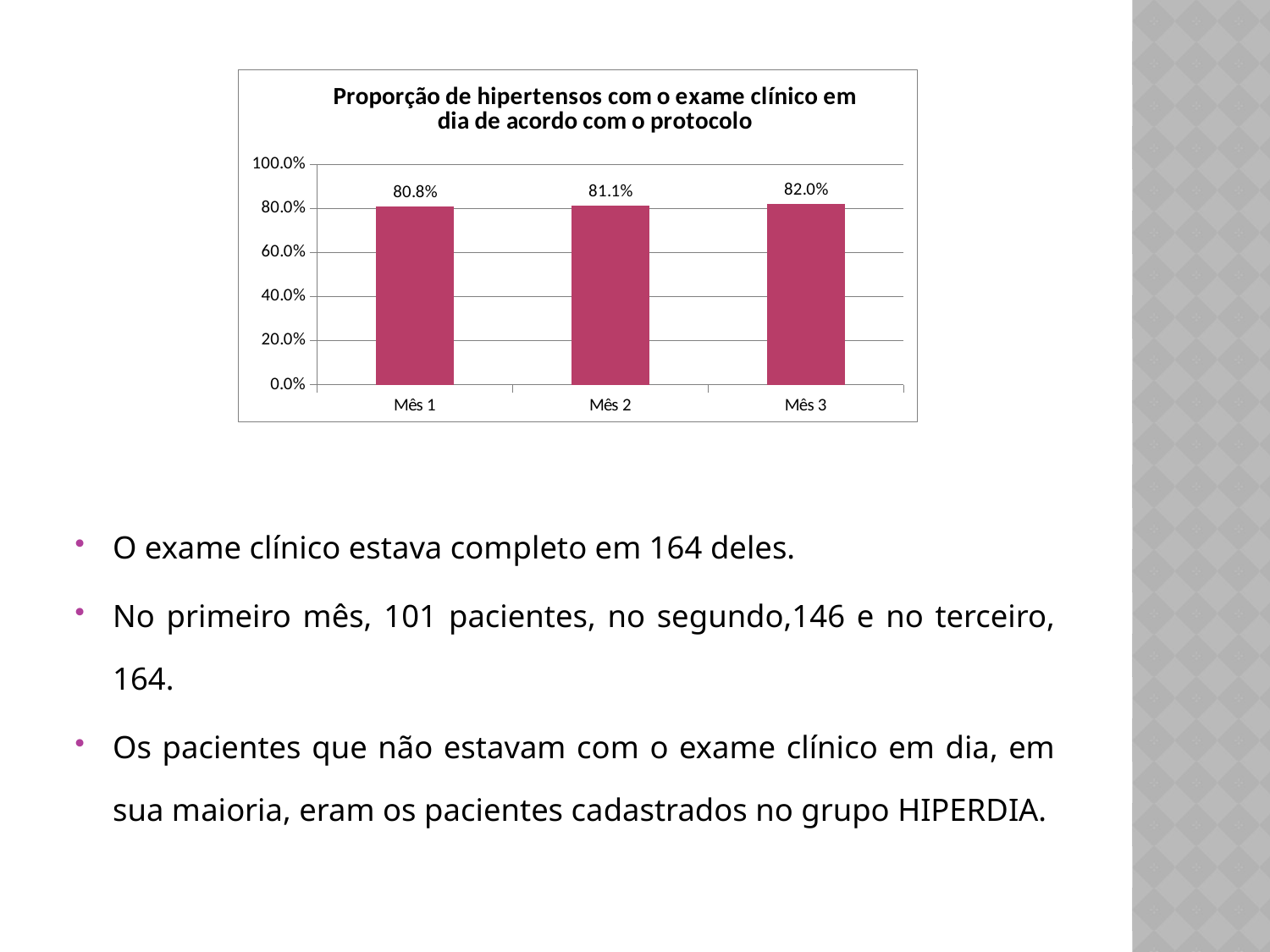
What kind of chart is shown on the slide? bar chart Which is larger, the value for Mês 2 or the value for Mês 1? Mês 2 What is the value for Mês 3? 82.0% Do the values rise or fall from Mês 1 to Mês 3? rise What is the value for Mês 2? 81.1% Which month has the highest proportion? Mês 3 What is the title of the chart? Proporção de hipertensos com o exame clínico em dia de acordo com o protocolo Is the value for Mês 1 greater or less than 60.0%? greater Which month has the lowest proportion? Mês 1 What is the value for Mês 1? 80.8% How many categories are shown on the x axis? 3 What is the difference between the values for Mês 3 and Mês 1? 1.2 percentage points